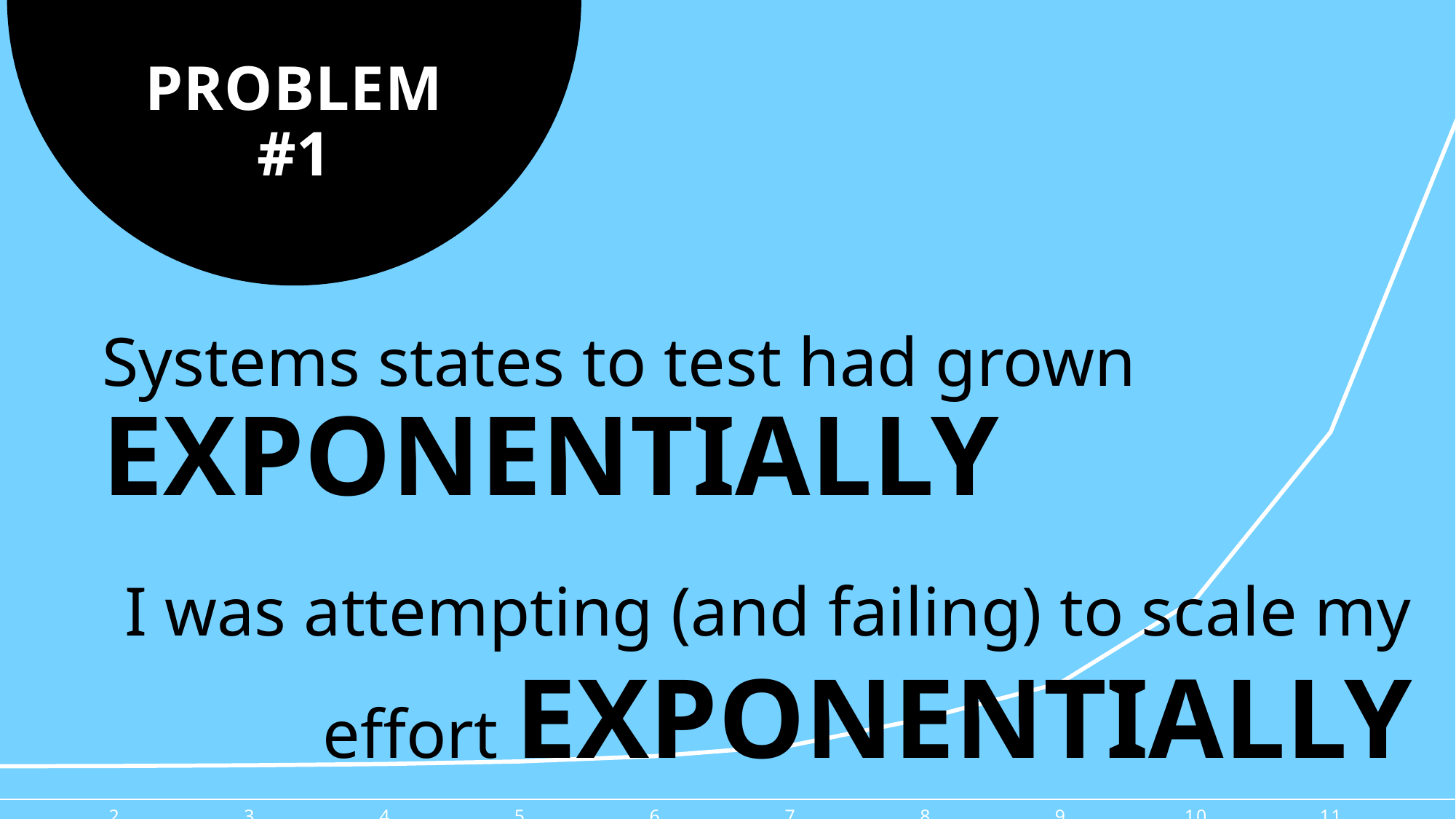
Which has the larger value on the line, x = 3 or x = 9? 9 Do the values of the line rise or fall as the x axis goes from 2 to 11? rise What kind of chart is shown in the background of the slide? line chart Which has the larger value on the line, x = 10 or x = 5? 10 What is the largest x-axis label shown on the chart? 11 What colour is the line plotted on the chart? white